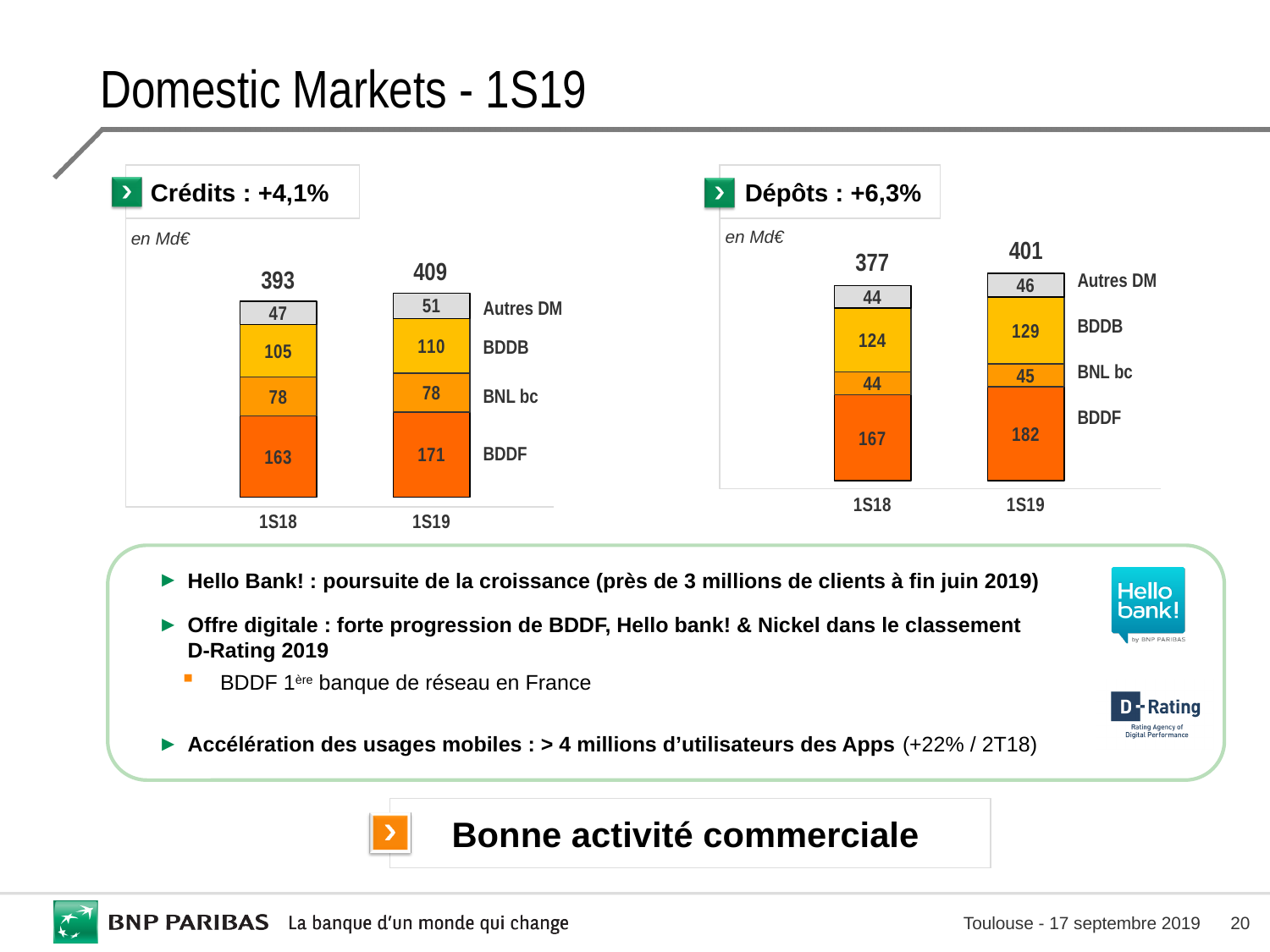
In the Dépôts chart, what is the value for BDDB in 1S18? 124 In the Crédits chart, which segment is the largest in 1S19? BDDF How many segments make up each stacked bar in the Dépôts chart? 4 In the Dépôts chart, which segment is the smallest in 1S18? Autres DM and BNL bc (both 44) In the Crédits chart, what is the total of the 1S18 stacked bar? 393 In the Crédits chart, what is the value for BDDF in 1S19? 171 What kind of chart is the Crédits chart? Stacked bar chart In the Crédits chart, is the BNL bc value larger in 1S18 or 1S19? They are equal (78) In the Dépôts chart, what is the difference between the BDDF values for 1S19 and 1S18? 15 In the Dépôts chart, does the total rise or fall from 1S18 to 1S19? Rise What growth rate is shown in the title of the Dépôts chart? +6,3% In the Dépôts chart, what is the total of the 1S19 stacked bar? 401